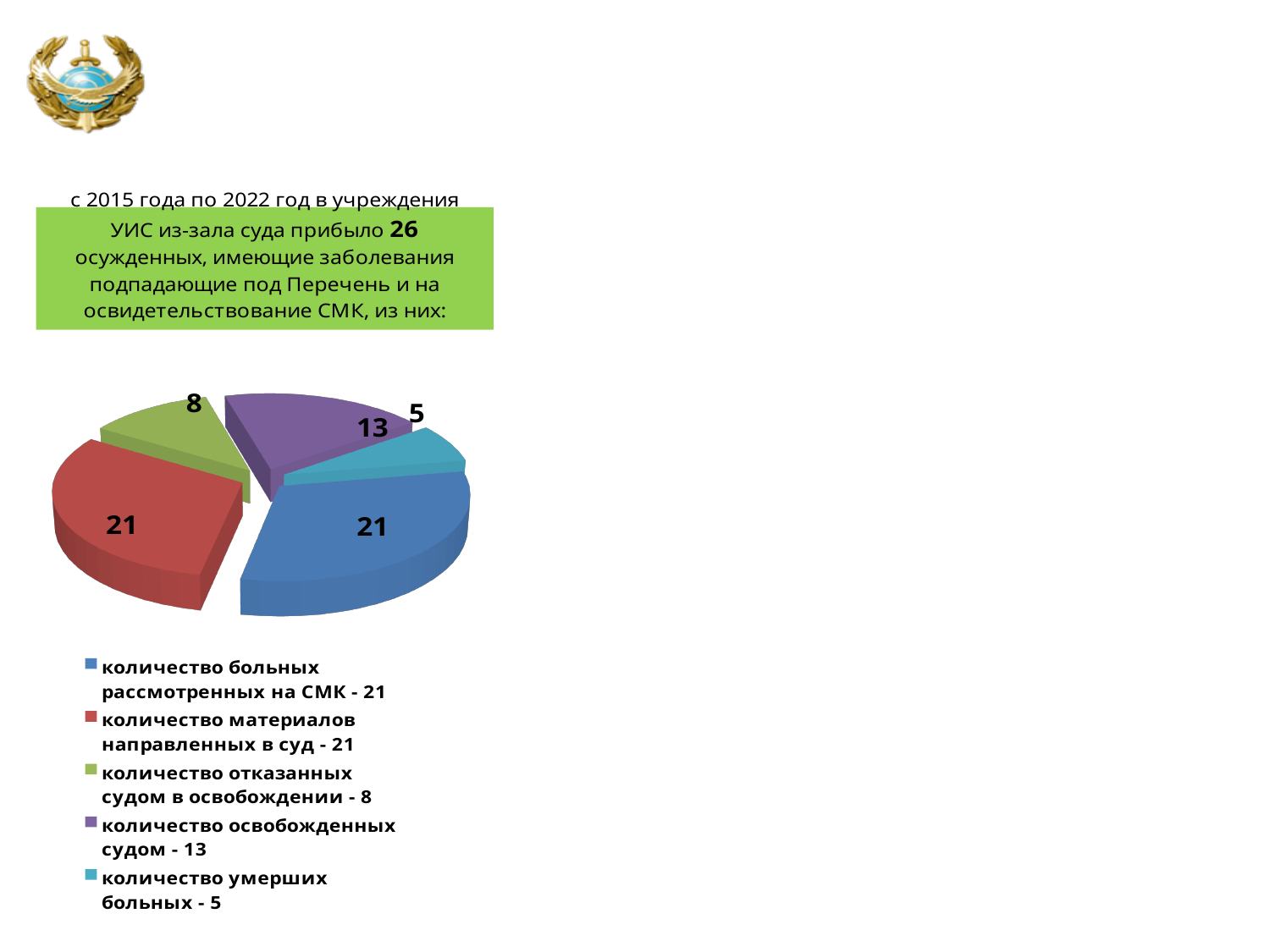
How many entries does the legend of the pie chart list? 5 What is the value of the slice for "количество умерших больных"? 5 What is the value of the slice for "количество отказанных судом в освобождении"? 8 What kind of chart is shown on the slide? pie chart How many slices does the pie chart have? 5 Which is larger: the value for "количество освобожденных судом" or the value for "количество умерших больных"? количество освобожденных судом What is the largest value shown on the pie chart? 21 What is the value of the slice for "количество освобожденных судом"? 13 What colour is the slice for "количество материалов направленных в суд"? red Which category has the smallest slice in the pie chart? количество умерших больных What is the value of the slice for "количество больных рассмотренных на СМК"? 21 What is the difference between the value for "количество освобожденных судом" and the value for "количество отказанных судом в освобождении"? 5